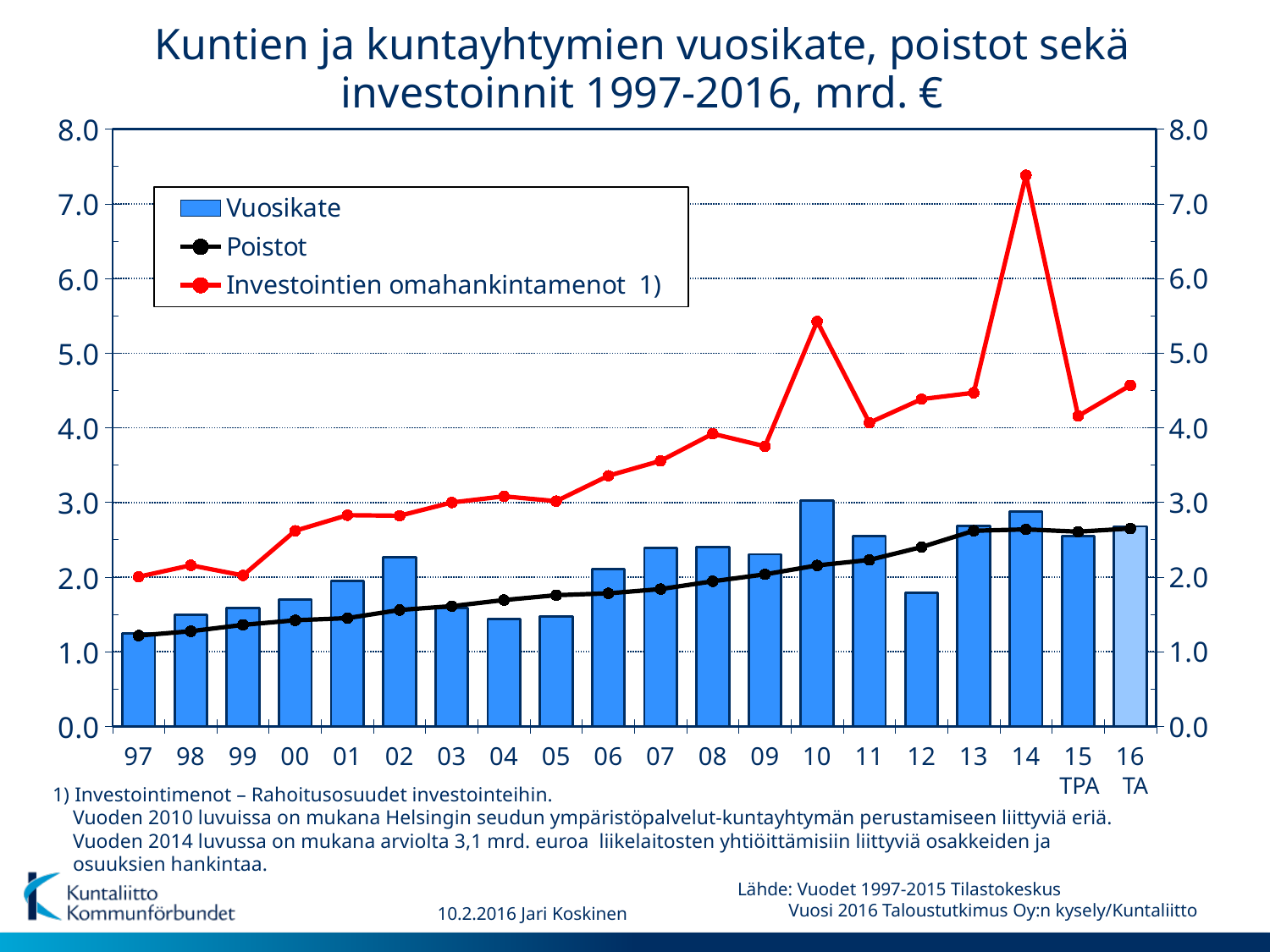
Which is larger, the Vuosikate value in 10 or in 12? 10 Is the value of Investointien omahankintamenot in 14 greater or less than 7.0? greater How many years are shown on the x axis? 20 Is the value of Investointien omahankintamenot in 10 greater or less than 5.0? greater What colour is the Investointien omahankintamenot line? Red How many series does the legend list? 3 What kind of chart is shown on the slide? Combined bar and line chart In which year is the Vuosikate bar the highest? 10 Does the Poistot line generally rise or fall from 97 to 16? rise In which year is the Vuosikate bar the lowest? 97 In which year does the Investointien omahankintamenot line reach its highest point? 14 Is the Vuosikate value in 12 greater or less than 2.0? less